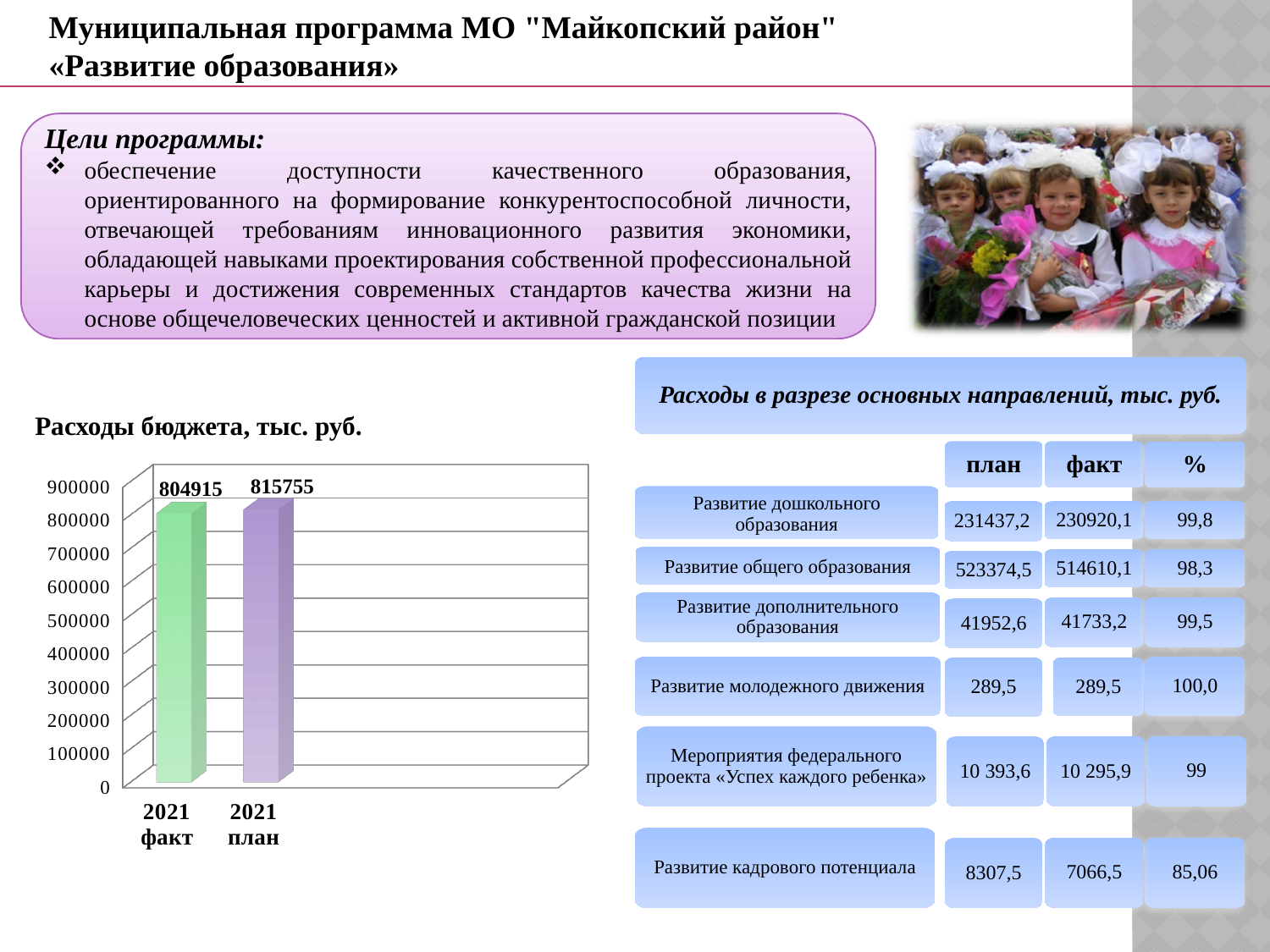
Is the value for "2021 факт" greater or less than the value for "2021 план" in the chart "Расходы бюджета, тыс. руб."? less Which category has the higher value in the chart "Расходы бюджета, тыс. руб."? 2021 план What is the maximum value shown on the vertical axis of the chart "Расходы бюджета, тыс. руб."? 900000 What is the title of the chart on the left side of the slide? Расходы бюджета, тыс. руб. How many bars are shown in the chart "Расходы бюджета, тыс. руб."? 2 What is the value for "2021 факт" in the chart "Расходы бюджета, тыс. руб."? 804915 Is the value for "2021 план" greater or less than 800000 in the chart "Расходы бюджета, тыс. руб."? greater Is the value for "2021 факт" greater or less than 900000 in the chart "Расходы бюджета, тыс. руб."? less What type of chart is "Расходы бюджета, тыс. руб."? bar chart Which category has the lower value in the chart "Расходы бюджета, тыс. руб."? 2021 факт What is the difference between the "2021 план" and "2021 факт" values in the chart "Расходы бюджета, тыс. руб."? 10840 What is the value for "2021 план" in the chart "Расходы бюджета, тыс. руб."? 815755